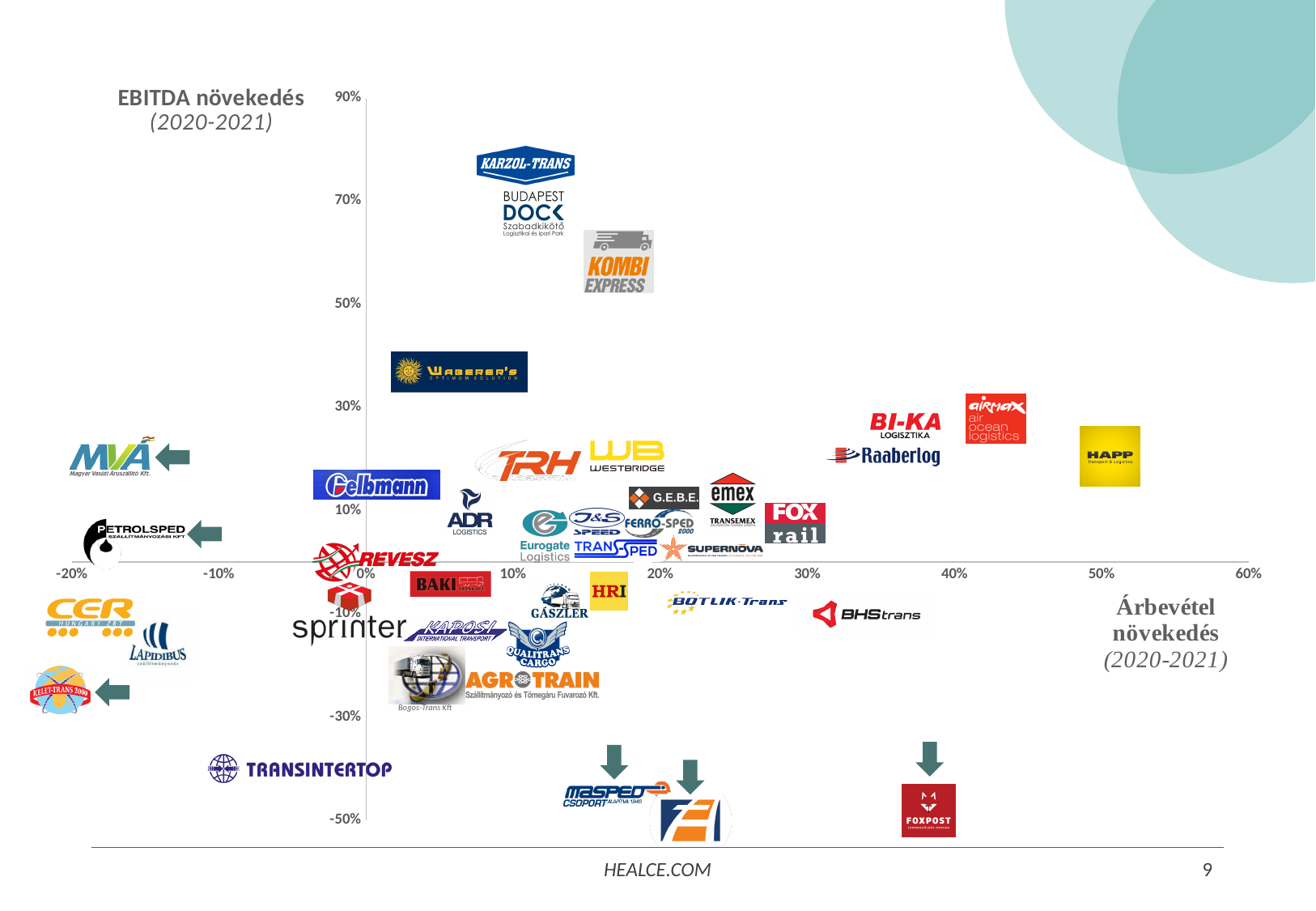
Is the revenue growth for MVA greater or less than -10%? less Which company has the highest EBITDA growth on the chart? Karzol-Trans Is the EBITDA growth for Transintertop greater or less than -30%? less What does the horizontal axis of the chart measure? Árbevétel növekedés (2020-2021) Which has the higher revenue growth, HAPP or Kelet-Trans? HAPP What kind of chart is shown on the slide? Scatter chart Which company has the highest revenue growth (Árbevétel növekedés) on the chart? HAPP Which has the higher EBITDA growth, Karzol-Trans or Waberer's? Karzol-Trans Is the EBITDA growth for Karzol-Trans greater or less than 70%? greater What does the vertical axis of the chart measure? EBITDA növekedés (2020-2021)